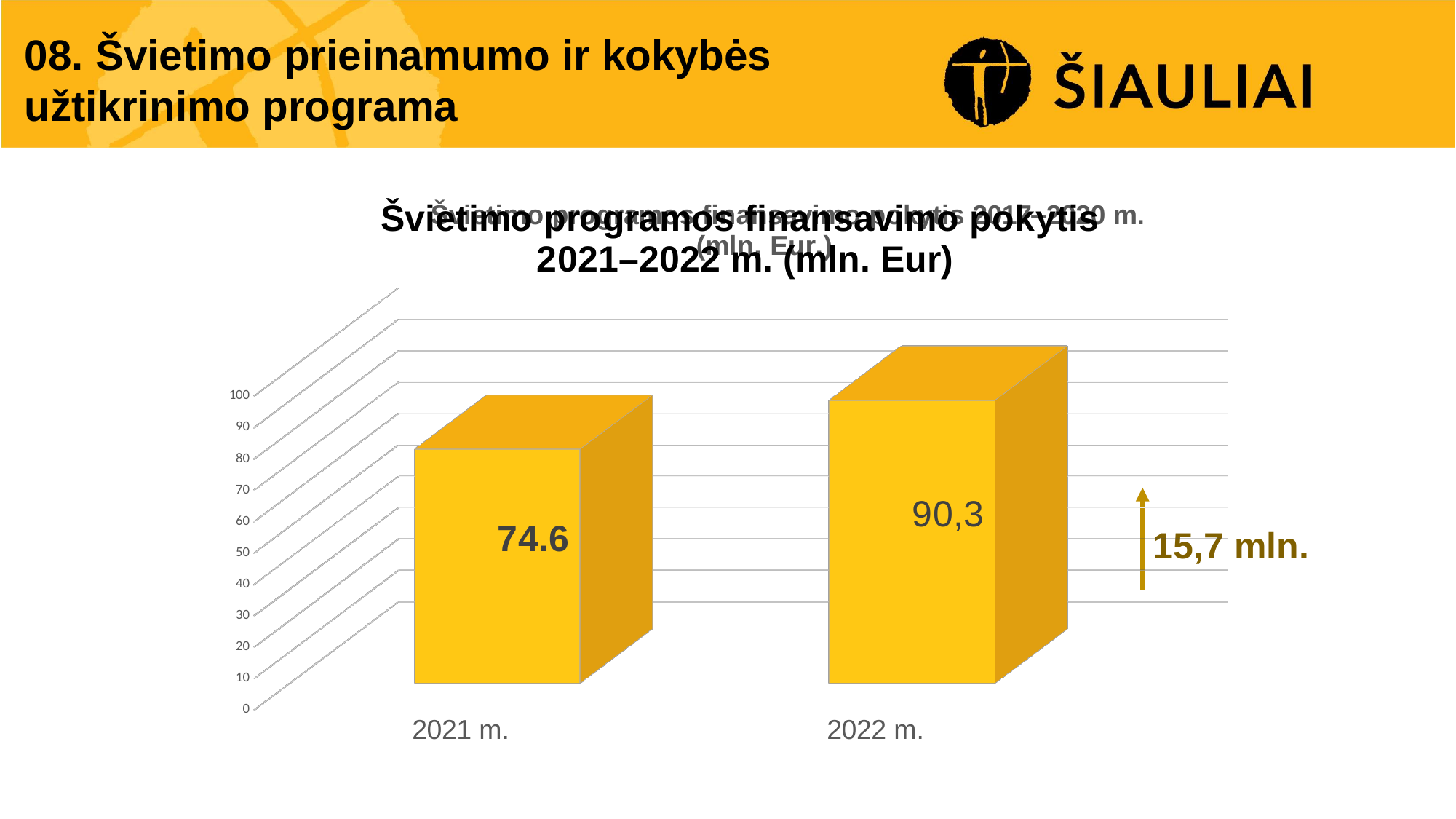
What kind of chart is shown on the slide? bar chart Do the values rise or fall from 2021 m. to 2022 m.? rise Is the value for 2022 m. larger or smaller than the value for 2021 m.? larger What is the difference between the 2022 m. and 2021 m. values? 15,7 Is the value for 2022 m. greater or less than 80? greater What is the value for 2022 m.? 90,3 What change in funding is indicated by the arrow annotation next to the chart? 15,7 mln. Which year has the lower value? 2021 m. What is the value for 2021 m.? 74.6 Which year has the higher value? 2022 m. How many categories (years) are shown in the chart? 2 Is the value for 2021 m. greater or less than 80? less